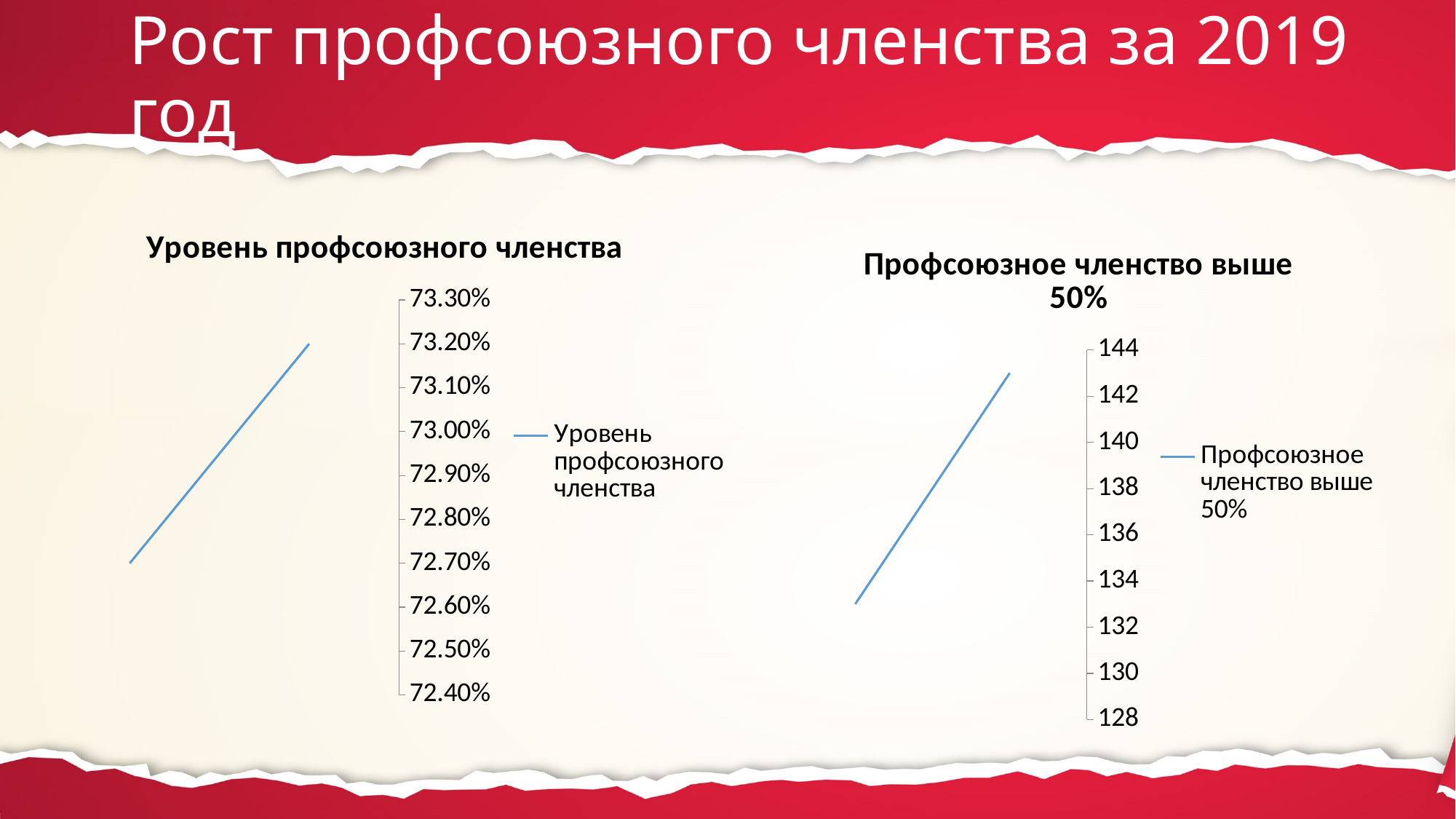
How many series does the legend of the right chart 'Профсоюзное членство выше 50%' list? 1 In the right chart 'Профсоюзное членство выше 50%', is the value at the end of the line greater or less than 140? greater What is the legend entry of the left chart 'Уровень профсоюзного членства'? Уровень профсоюзного членства In the left chart 'Уровень профсоюзного членства', is the value at the start of the line greater or less than 73.00%? less What kind of chart is the left chart titled 'Уровень профсоюзного членства'? line chart In the left chart 'Уровень профсоюзного членства', do the values rise or fall along the x axis? rise How many series does the legend of the left chart 'Уровень профсоюзного членства' list? 1 In the right chart 'Профсоюзное членство выше 50%', do the values rise or fall along the x axis? rise What kind of chart is the right chart titled 'Профсоюзное членство выше 50%'? line chart In the left chart 'Уровень профсоюзного членства', is the value at the end of the line greater or less than 73.00%? greater What is the title of the chart on the right side of the slide? Профсоюзное членство выше 50%